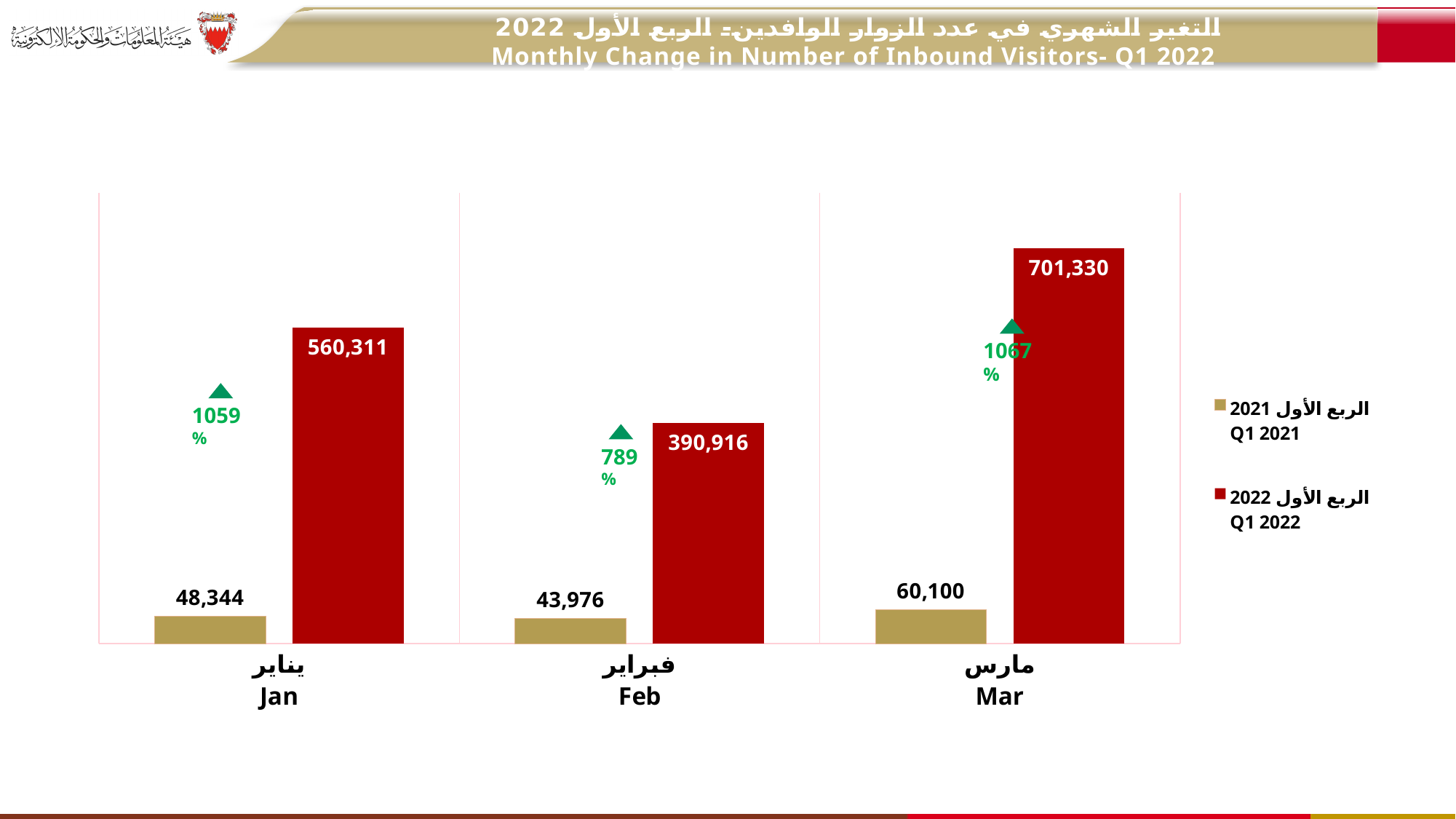
What is the value for Q1 2021 in Feb? 43,976 What is the value for Q1 2022 in Mar? 701,330 Which month has the highest Q1 2022 value? Mar What is the value for Q1 2021 in Mar? 60,100 What is the difference between the Q1 2022 and Q1 2021 values for Mar? 641,230 Which is larger, the Q1 2022 value for Jan or for Feb? Jan What is the difference between the Q1 2022 values for Jan and Feb? 169,395 What is the value for Q1 2022 in Jan? 560,311 How many months are shown on the x axis? 3 Which month has the lowest Q1 2021 value? Feb What percentage change is shown above the Feb bars? 789% How many series does the legend list? 2